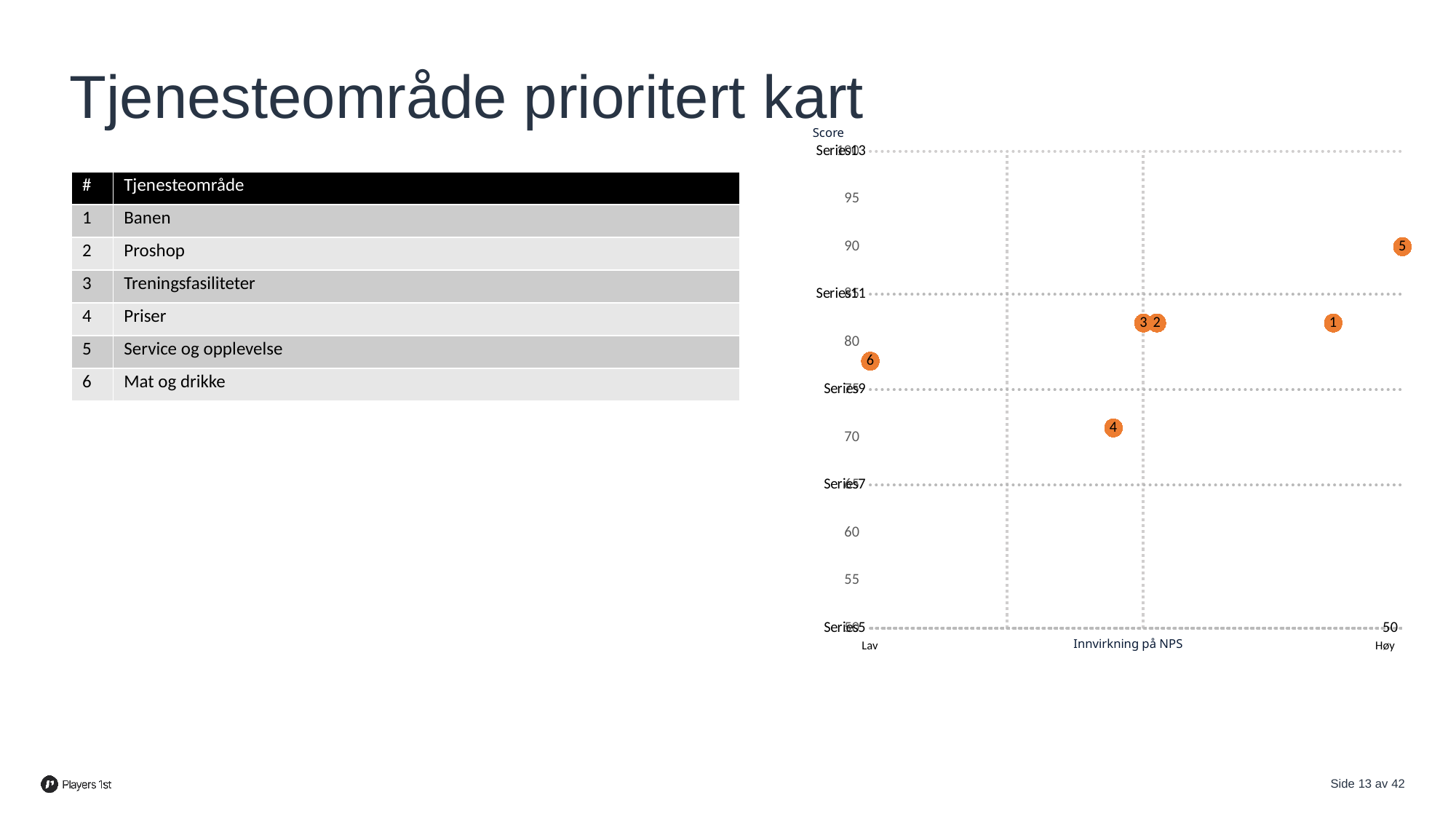
What kind of chart is shown on the right of the slide? scatter chart Which numbered point has the lowest Score on the chart? 4 Which has the higher Score, point 1 or point 6? 1 Is the Score for point 5 greater or less than 85? greater Is the Score for point 1 greater or less than 80? greater What is the title of the horizontal axis of the chart? Innvirkning på NPS Which numbered point has the highest Score on the chart? 5 Is the Score for point 4 greater or less than 75? less Which has the higher Score, point 5 or point 4? 5 Which numbered point is furthest to the right on the Innvirkning på NPS axis? 5 How many numbered points are plotted on the chart? 6